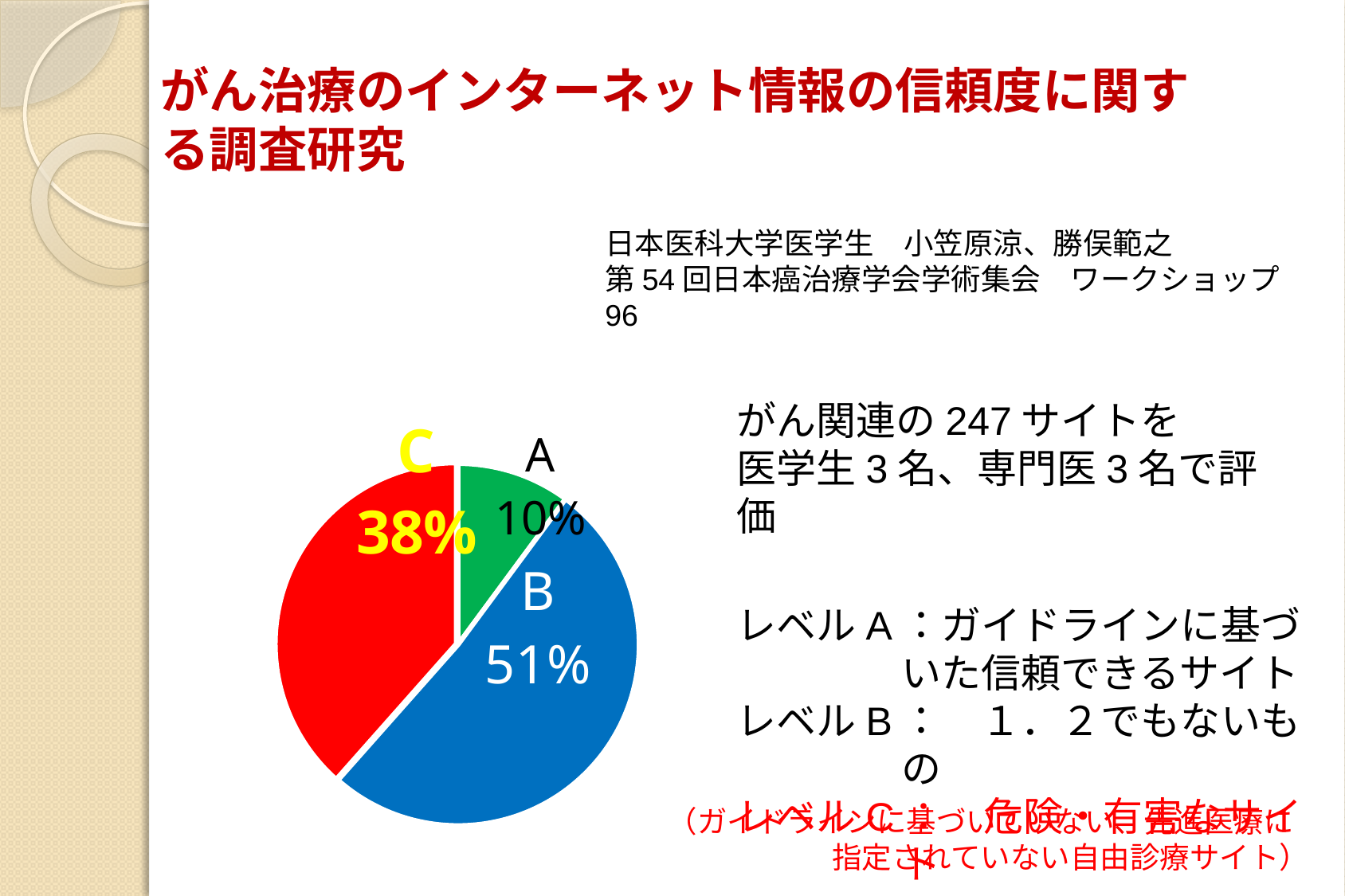
What kind of chart is shown on the slide? pie chart What percentage is shown for slice A in the pie chart? 10% How many slices does the pie chart have? 3 Which slice of the pie chart is the smallest? A What percentage is shown for slice B in the pie chart? 51% Which slice of the pie chart is the largest? B Which is larger, slice C or slice A? C What is the difference in percentage points between slice B and slice C? 13 What colour is slice B in the pie chart? blue What colour is slice C in the pie chart? red What is the difference in percentage points between slice C and slice A? 28 What percentage is shown for slice C in the pie chart? 38%